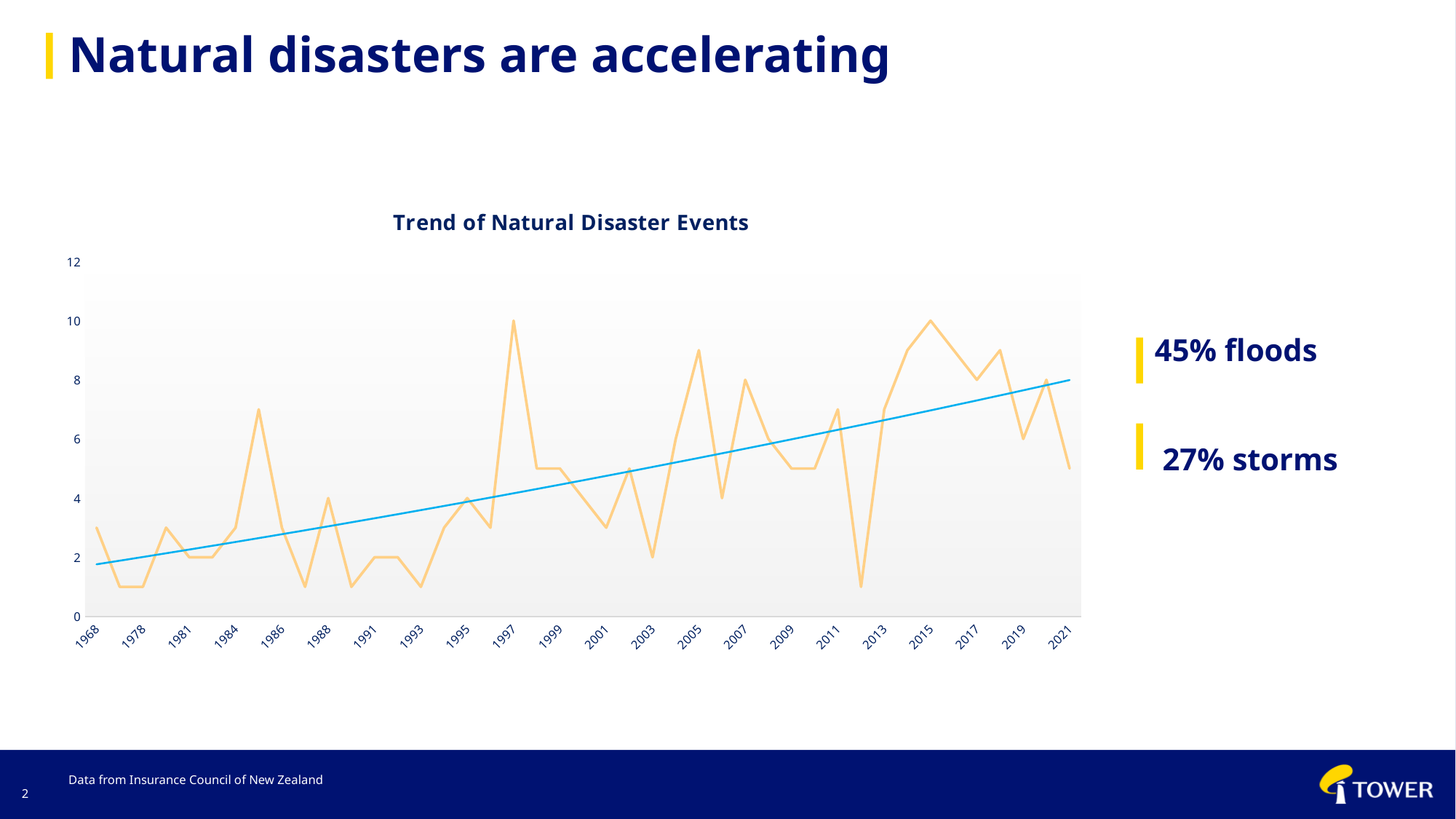
Is the value for 2003 greater or less than 4? less Does the trend line in the chart rise or fall from 1968 to 2021? rises What is the number of natural disaster events in 2015? 10 What is the highest value shown on the y axis of the chart? 12 Is the value for 2019 greater or less than 8? less Is the value for 2005 greater or less than 8? greater What is the number of natural disaster events in 1997? 10 What type of chart is shown on the slide? line chart Which year has more natural disaster events, 1997 or 2021? 1997 What is the title of the chart? Trend of Natural Disaster Events